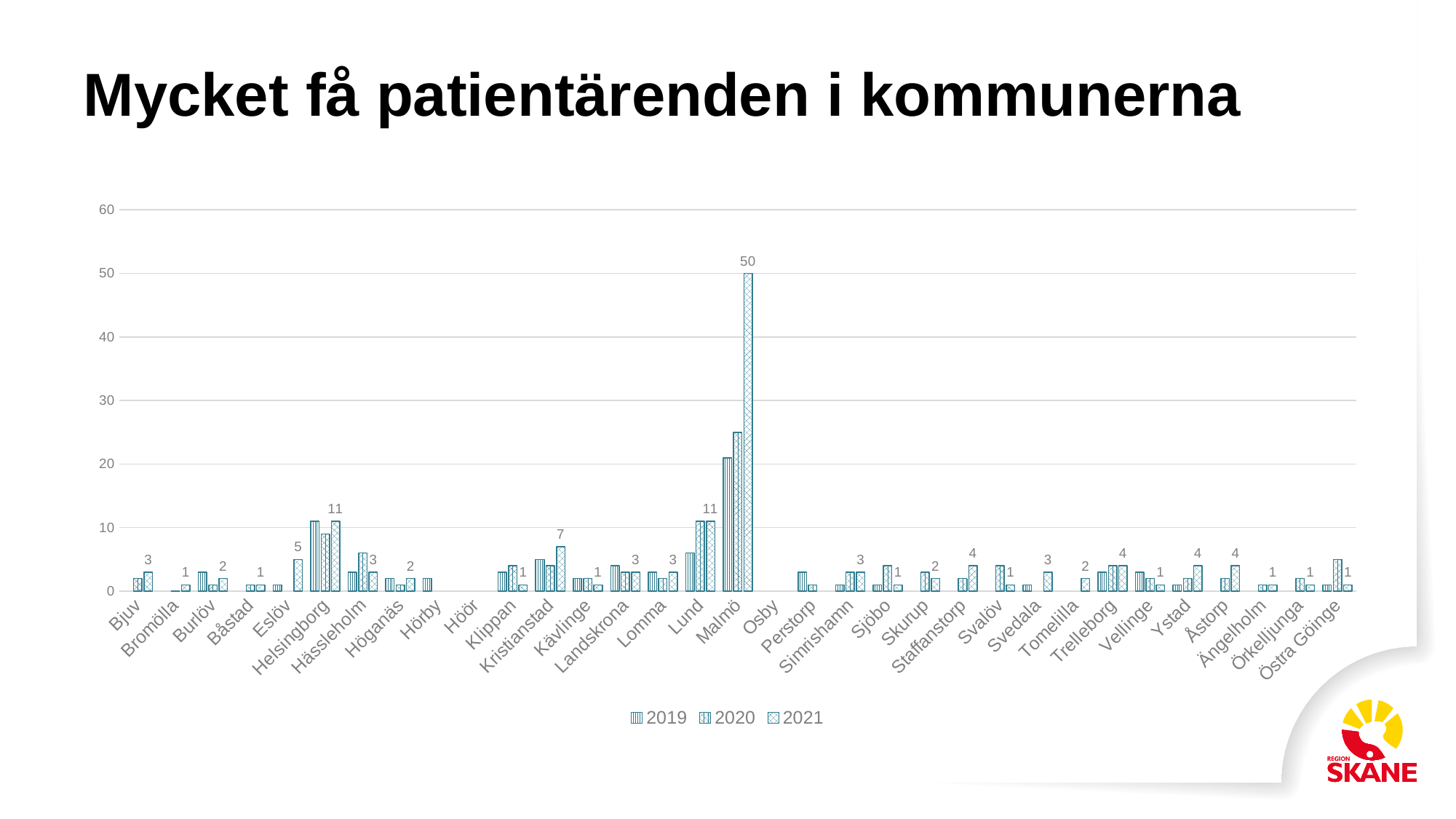
How many municipalities are shown on the x axis? 33 What is the value for Eslöv in 2021? 5 What is the value for Malmö in 2021? 50 What is the value for Helsingborg in 2021? 11 What kind of chart is shown on the slide? Bar chart What is the value for Kristianstad in 2021? 7 What is the title of the slide? Mycket få patientärenden i kommunerna Is the value for Malmö in 2020 greater or less than 20? greater Which municipality has the highest value in 2021? Malmö Which is larger in 2021, the value for Eslöv or the value for Bjuv? Eslöv How many series does the legend list? 3 What is the difference between the 2021 values for Malmö and Lund? 39